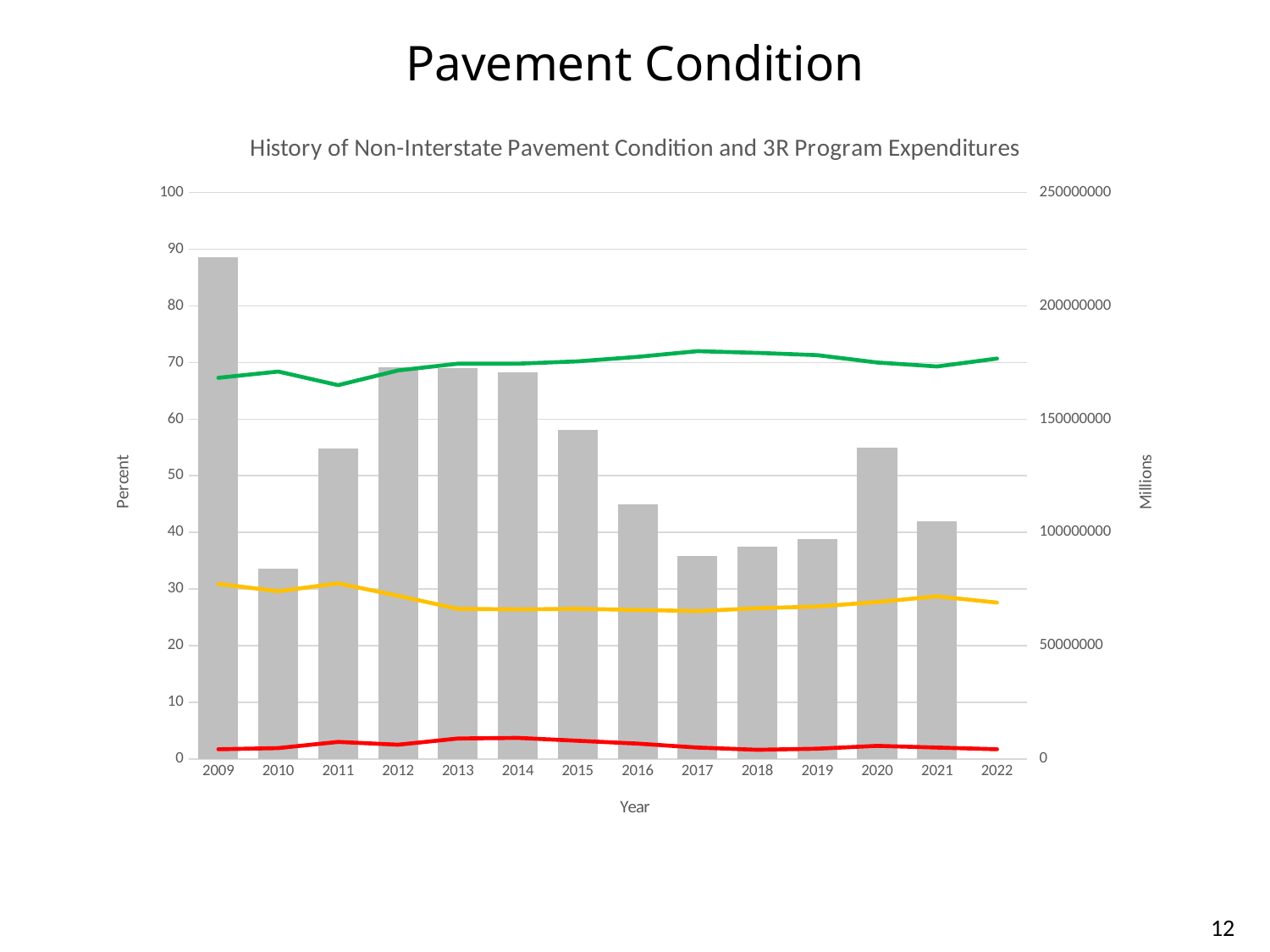
Which year has the tallest bar in the chart? 2009 Is the bar for 2020 greater or less than 150000000 on the right axis? less Is the bar for 2010 greater or less than 100000000 on the right axis? less Is the bar for 2012 greater or less than 150000000 on the right axis? greater Which bar is taller, 2012 or 2016? 2012 What is the label of the left vertical axis? Percent How many years are shown on the x axis of the chart? 14 What kind of chart is shown on the slide? Combined bar and line chart What is the title of the chart? History of Non-Interstate Pavement Condition and 3R Program Expenditures